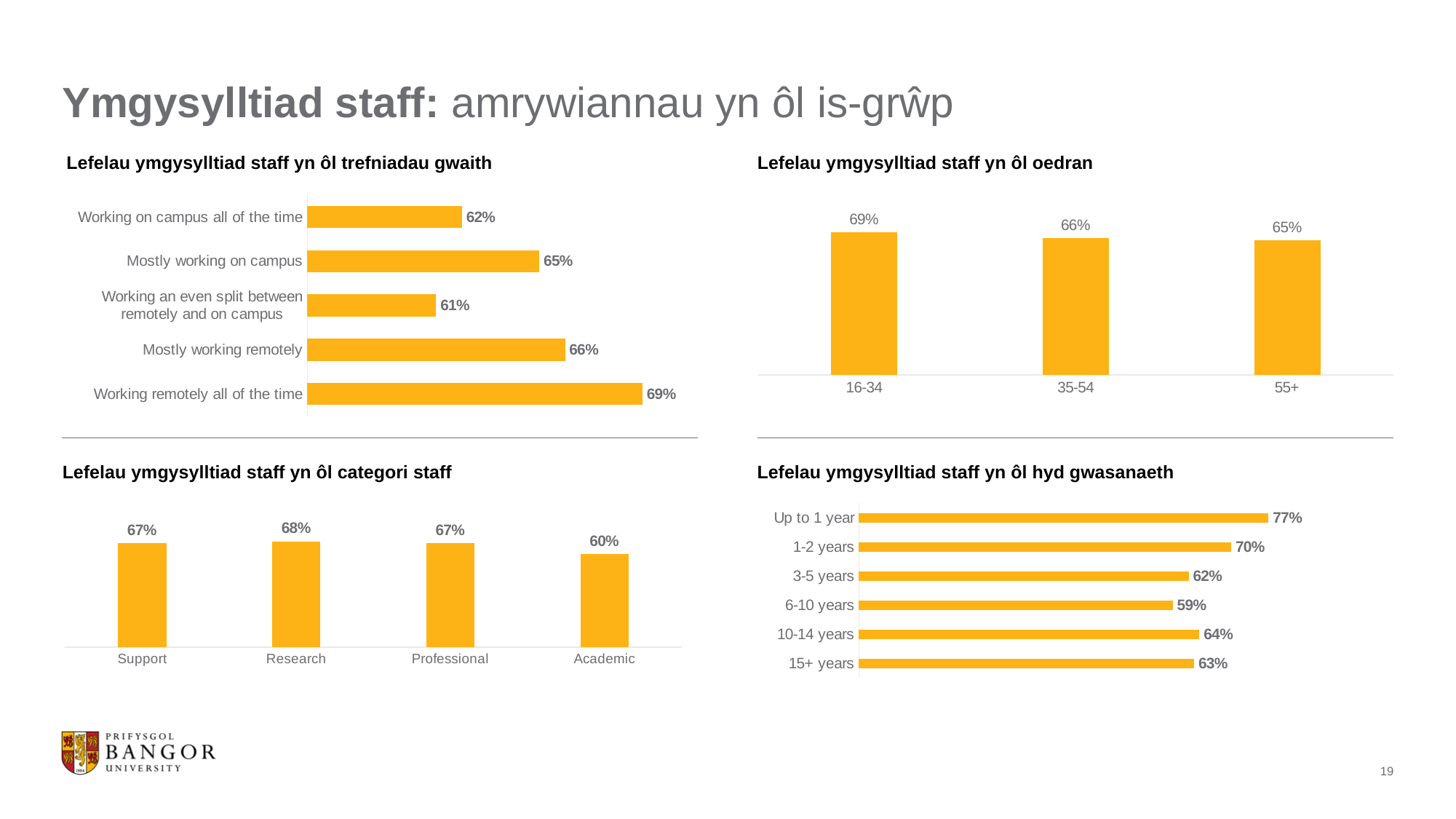
In the chart 'Lefelau ymgysylltiad staff yn ôl trefniadau gwaith', what is the value for 'Working remotely all of the time'? 69% In the chart 'Lefelau ymgysylltiad staff yn ôl oedran', what is the value for the 35-54 age group? 66% In the chart 'Lefelau ymgysylltiad staff yn ôl hyd gwasanaeth', what is the difference between the values for 'Up to 1 year' and '3-5 years'? 15% In the chart 'Lefelau ymgysylltiad staff yn ôl categori staff', which staff category has the highest value? Research In the chart 'Lefelau ymgysylltiad staff yn ôl oedran', which age group has the highest value? 16-34 In the chart 'Lefelau ymgysylltiad staff yn ôl categori staff', what is the value for Academic? 60% In the chart 'Lefelau ymgysylltiad staff yn ôl hyd gwasanaeth', what is the value for '6-10 years'? 59% In the chart 'Lefelau ymgysylltiad staff yn ôl categori staff', what kind of chart is used? Bar chart In the chart 'Lefelau ymgysylltiad staff yn ôl hyd gwasanaeth', which is larger, the value for '1-2 years' or '15+ years'? 1-2 years In the chart 'Lefelau ymgysylltiad staff yn ôl trefniadau gwaith', how many categories are shown? 5 In the chart 'Lefelau ymgysylltiad staff yn ôl oedran', what is the difference between the values for 16-34 and 55+? 4% In the chart 'Lefelau ymgysylltiad staff yn ôl trefniadau gwaith', which category has the lowest value? Working an even split between remotely and on campus